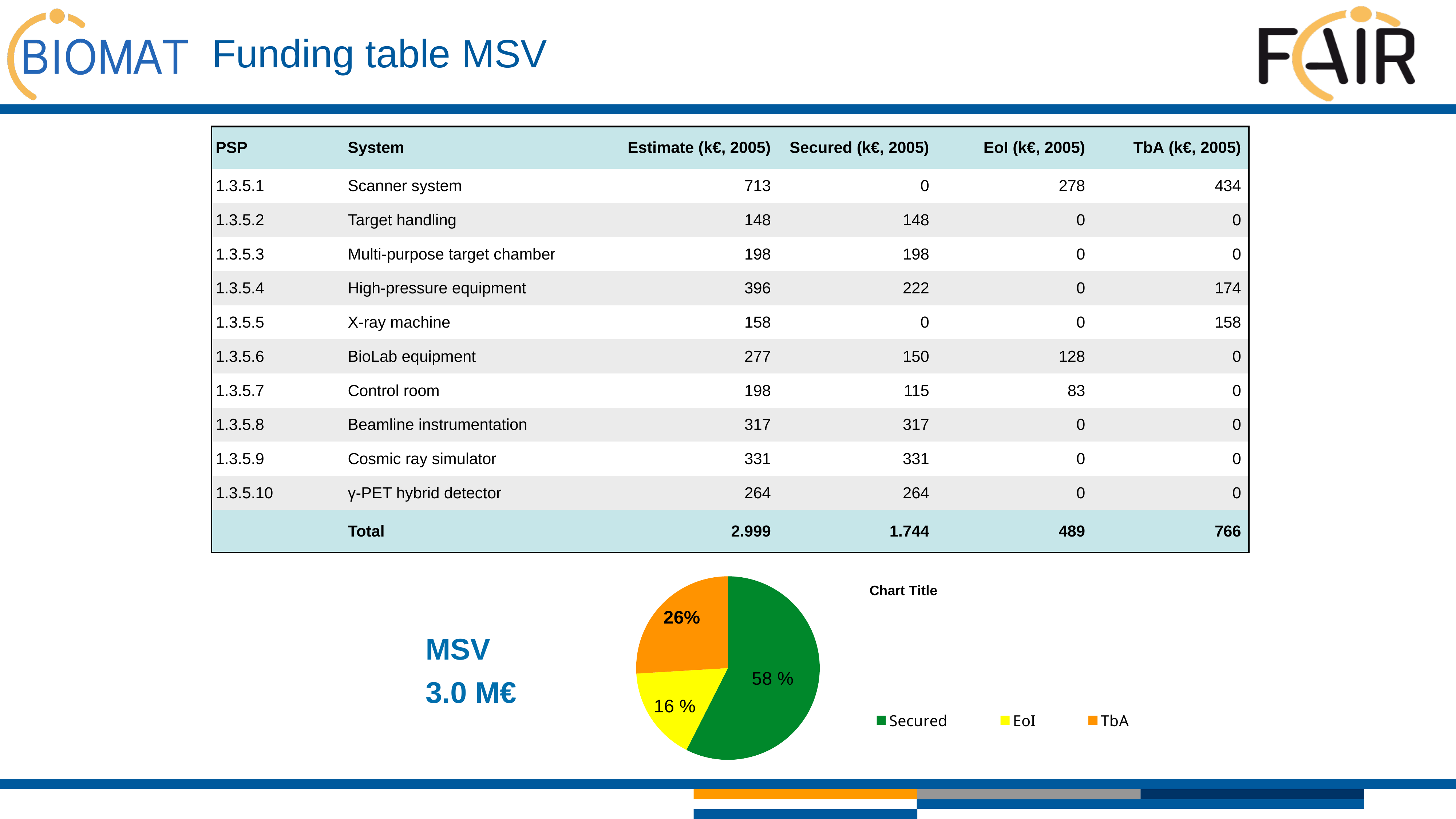
What is the difference in percentage points between the Secured slice and the TbA slice in the pie chart? 32 In the pie chart, which is larger, the TbA slice or the EoI slice? TbA How many entries does the pie chart's legend list? 3 What share of the pie chart does the EoI slice represent? 16 % Which slice of the pie chart is the smallest? EoI What colour is the Secured slice in the pie chart? green What share of the pie chart does the TbA slice represent? 26% Which slice of the pie chart is the largest? Secured What share of the pie chart does the Secured slice represent? 58 % What is the title shown on the pie chart? Chart Title How many slices does the pie chart have? 3 What kind of chart is shown on the slide? pie chart